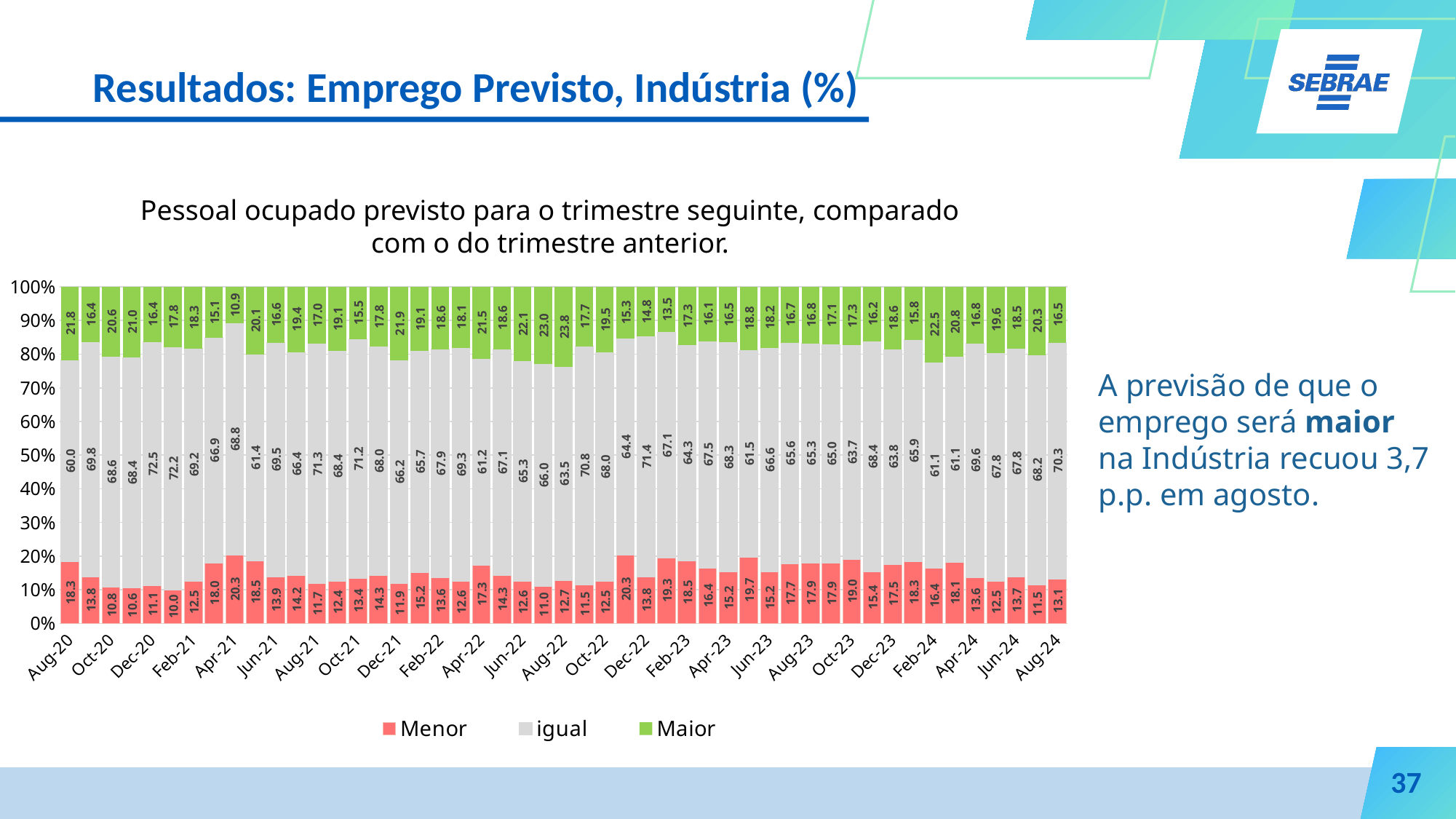
What is the value of the Maior series for Aug-24? 16.5 What kind of chart is shown on the slide? Stacked bar chart Which is larger, the Menor value for Aug-20 or the Menor value for Aug-24? Aug-20 Which month has the highest value in the Maior series? Aug-22 What is the value of the Maior series for Apr-21? 10.9 Which month has the lowest value in the Maior series? Apr-21 What is the value of the igual series for Dec-22? 71.4 What is the value of the Maior series for Feb-24? 22.5 How many series does the legend list? 3 What is the value of the Menor series for Aug-24? 13.1 What is the value of the igual series for Aug-24? 70.3 What is the difference between the Maior value for Aug-22 and the Maior value for Aug-24? 7.3